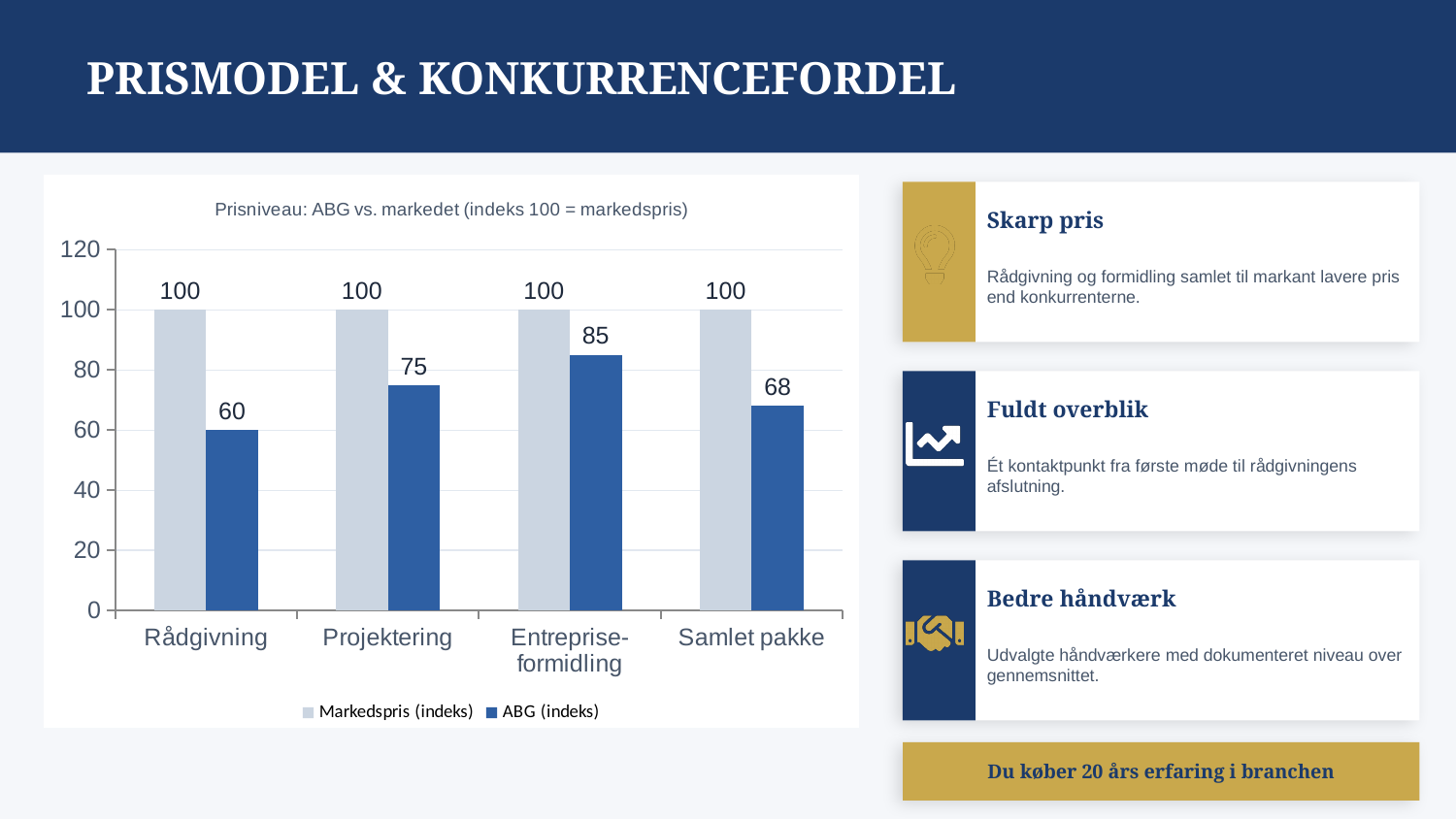
What is the title of the chart? Prisniveau: ABG vs. markedet (indeks 100 = markedspris) Which category has the lowest ABG (indeks) value? Rådgivning What is the difference between the Markedspris (indeks) and ABG (indeks) values for Samlet pakke? 32 What is the Markedspris (indeks) value for Projektering? 100 Which category has the highest ABG (indeks) value? Entreprise-formidling How many series does the legend list? 2 What is the difference between the ABG (indeks) values for Entreprise-formidling and Rådgivning? 25 How many categories are shown on the x axis? 4 Which is larger, the ABG (indeks) value for Projektering or for Samlet pakke? Projektering What is the ABG (indeks) value for Rådgivning? 60 What is the ABG (indeks) value for Entreprise-formidling? 85 What kind of chart is shown on the slide? Bar chart